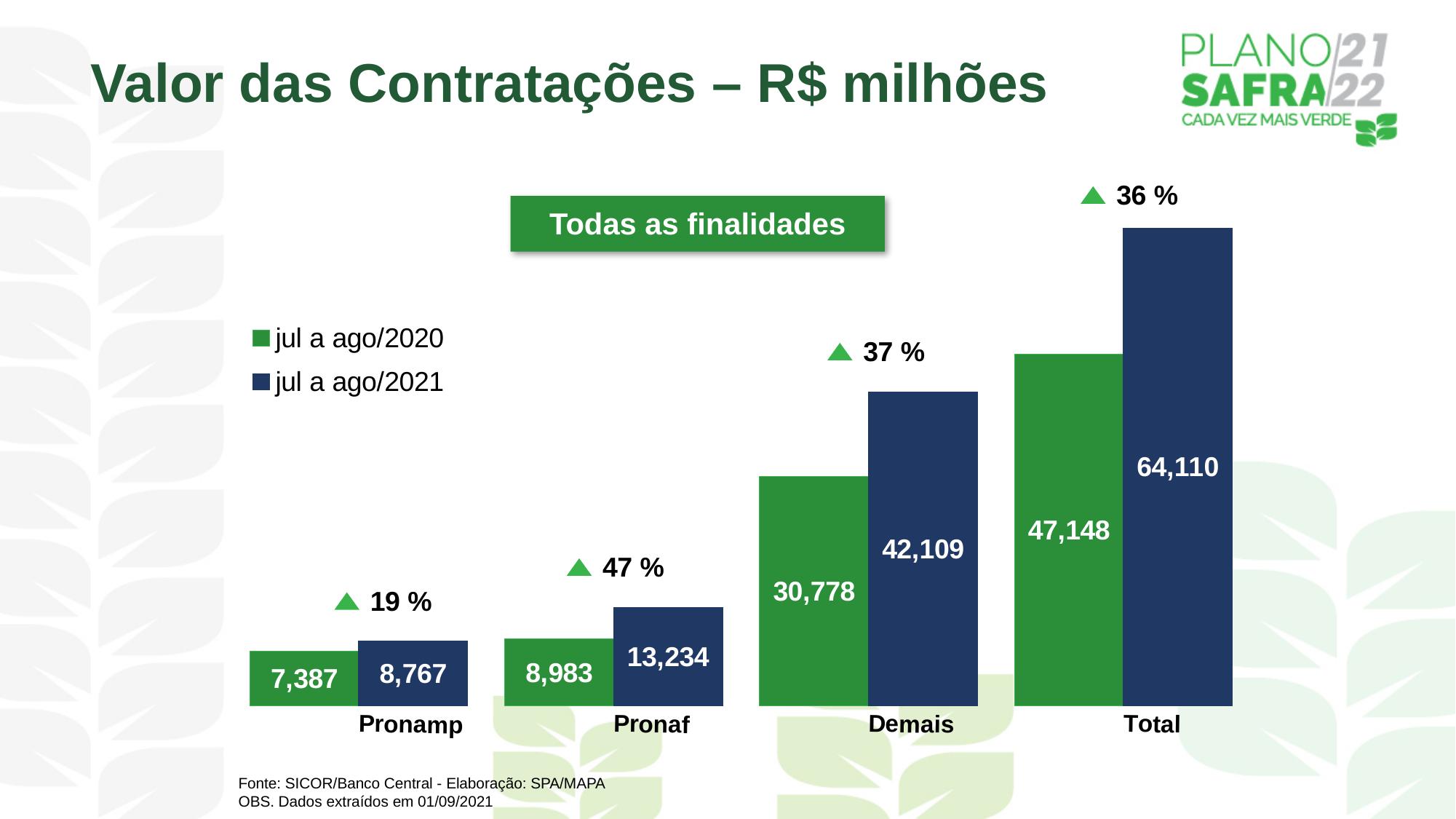
Which is larger for Pronaf: the jul a ago/2020 value or the jul a ago/2021 value? jul a ago/2021 What is the value for Demais in the jul a ago/2020 series? 30,778 What percentage increase is shown above the Pronaf bars? 47 % Excluding Total, which category has the highest value in the jul a ago/2021 series? Demais Which category has the lowest value in the jul a ago/2020 series? Pronamp What kind of chart is shown on the slide? Bar chart What is the Total value for jul a ago/2021? 64,110 What is the value for Pronamp in the jul a ago/2020 series? 7,387 What is the value for Pronaf in the jul a ago/2021 series? 13,234 How many series does the legend list? 2 How many categories are shown on the x axis? 4 What is the difference between the jul a ago/2021 and jul a ago/2020 values for Demais? 11,331